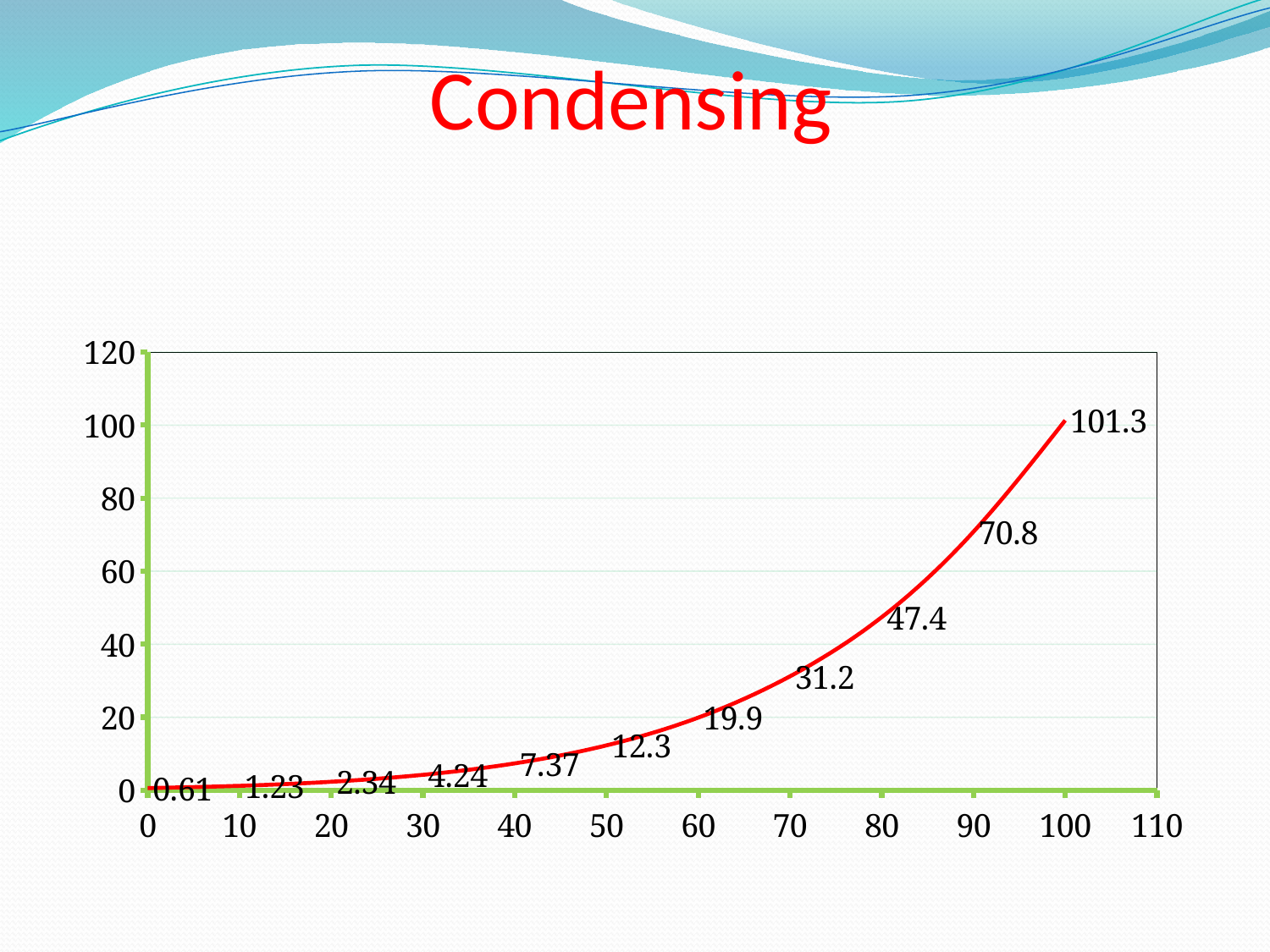
What is the value plotted at x = 50? 12.3 At which x value is the plotted value lowest? 0 What is the value plotted at x = 0? 0.61 Do the values rise or fall as x increases? rise What is the title of the slide? Condensing What is the difference between the values at x = 100 and x = 90? 30.5 What kind of chart is shown on the slide? line chart What is the value plotted at x = 70? 31.2 At which x value is the plotted value highest? 100 What is the value plotted at x = 100? 101.3 Which is larger, the value at x = 80 or the value at x = 70? x = 80 How many data points are labelled on the line? 11